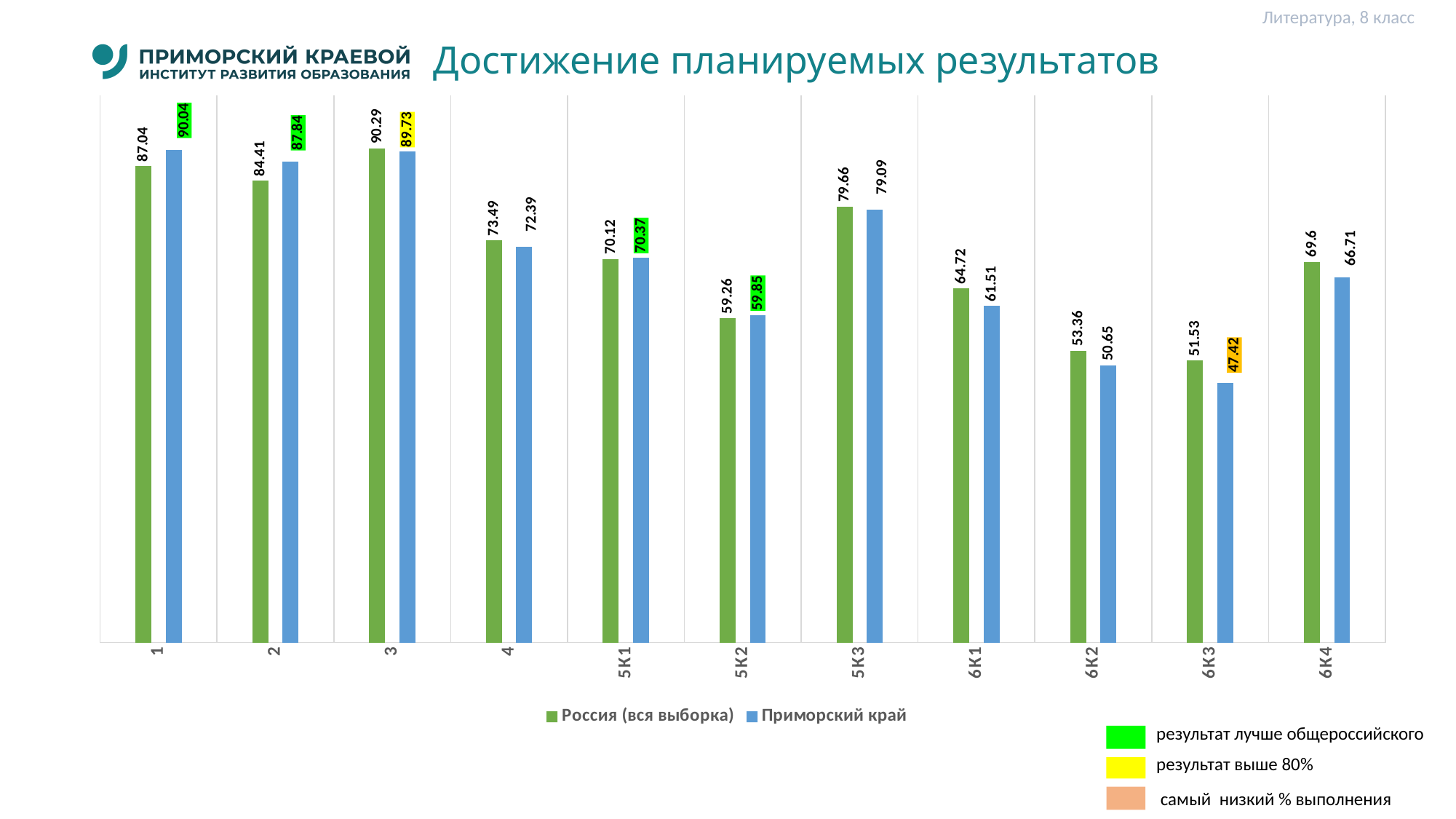
Which category has the lowest value for Приморский край? 6К3 What is the value for Россия (вся выборка) in category 6К3? 51.53 How many series does the legend list? 2 What is the difference between the Приморский край values for categories 1 and 6К3? 42.62 How many categories are shown on the x axis? 11 What is the value for Приморский край in category 1? 90.04 What colour are the bars for Приморский край? blue Which category has the highest value for Россия (вся выборка)? 3 What is the value for Приморский край in category 5К3? 79.09 What is the difference between Россия (вся выборка) and Приморский край in category 6К1? 3.21 In category 2, which series has the larger value: Россия (вся выборка) or Приморский край? Приморский край What type of chart is shown on the slide? bar chart